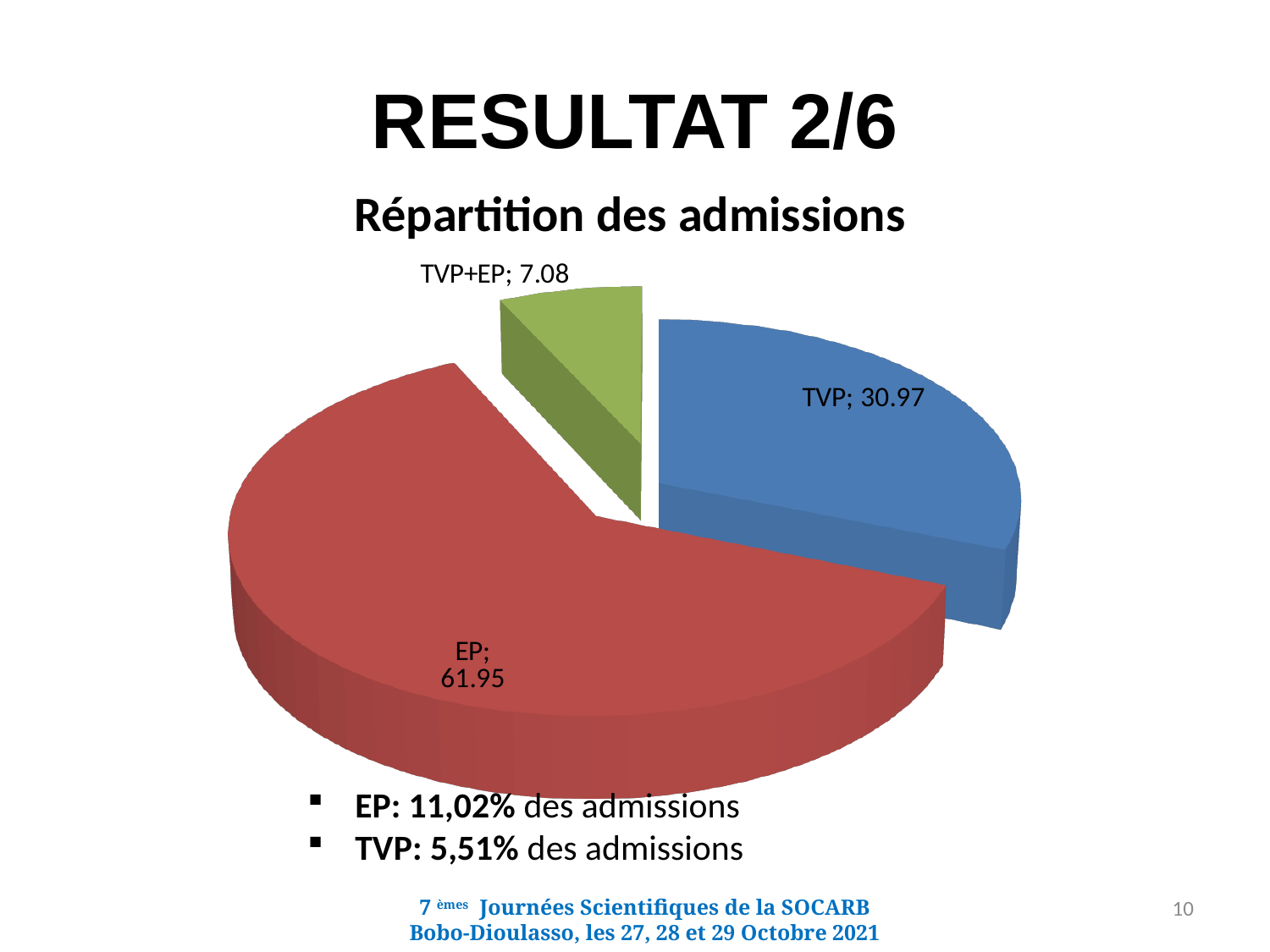
What kind of chart is shown on the slide? Pie chart What is the difference between the EP value and the TVP value? 30.98 What is the value shown for the TVP+EP slice? 7.08 Which category has the largest slice of the pie? EP Which category has the smallest slice of the pie? TVP+EP What is the title of the chart? Répartition des admissions What is the difference between the TVP value and the TVP+EP value? 23.89 What is the value shown for the EP slice? 61.95 How many slices does the pie chart have? 3 Which is larger, the TVP slice or the TVP+EP slice? TVP What colour is the EP slice? Red What is the value shown for the TVP slice? 30.97